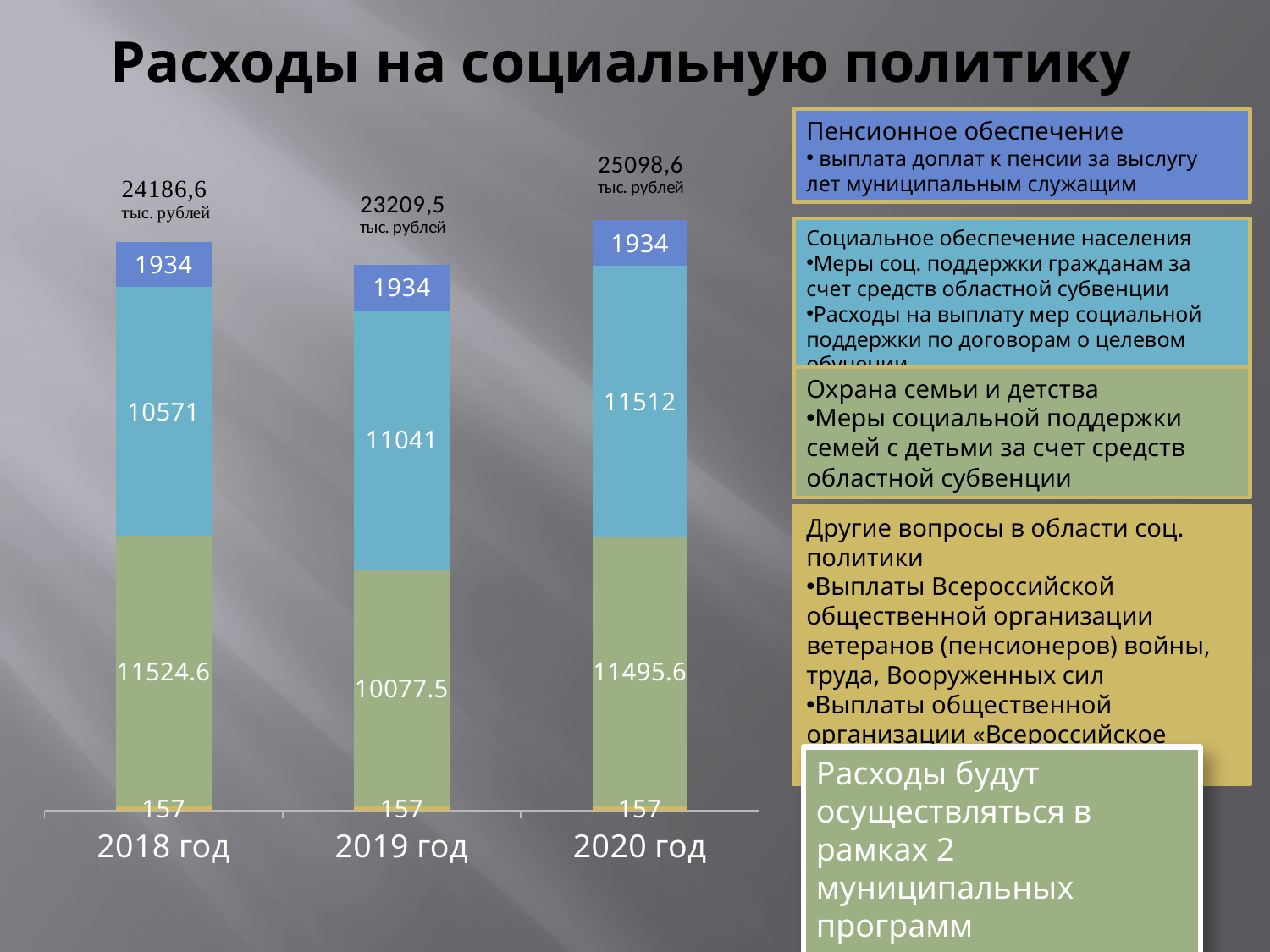
What kind of chart is shown on the slide? stacked bar chart What is the total value printed above the bar for 2020 год? 25098,6 тыс. рублей Which year has the highest total expenditure? 2020 год What is the value of the light blue segment in the 2020 год bar? 11512 What is the total value printed above the bar for 2018 год? 24186,6 тыс. рублей Is the green segment larger in 2018 год or in 2019 год? 2018 год What is the value of the green segment in the 2019 год bar? 10077.5 What is the value of the small yellow segment at the bottom of each bar? 157 What is the difference between the light blue segment values for 2020 год and 2018 год? 941 How many years (categories) are shown on the x axis of the chart? 3 Which year has the lowest total expenditure? 2019 год What is the value of the dark blue (top) segment in the 2018 год bar? 1934